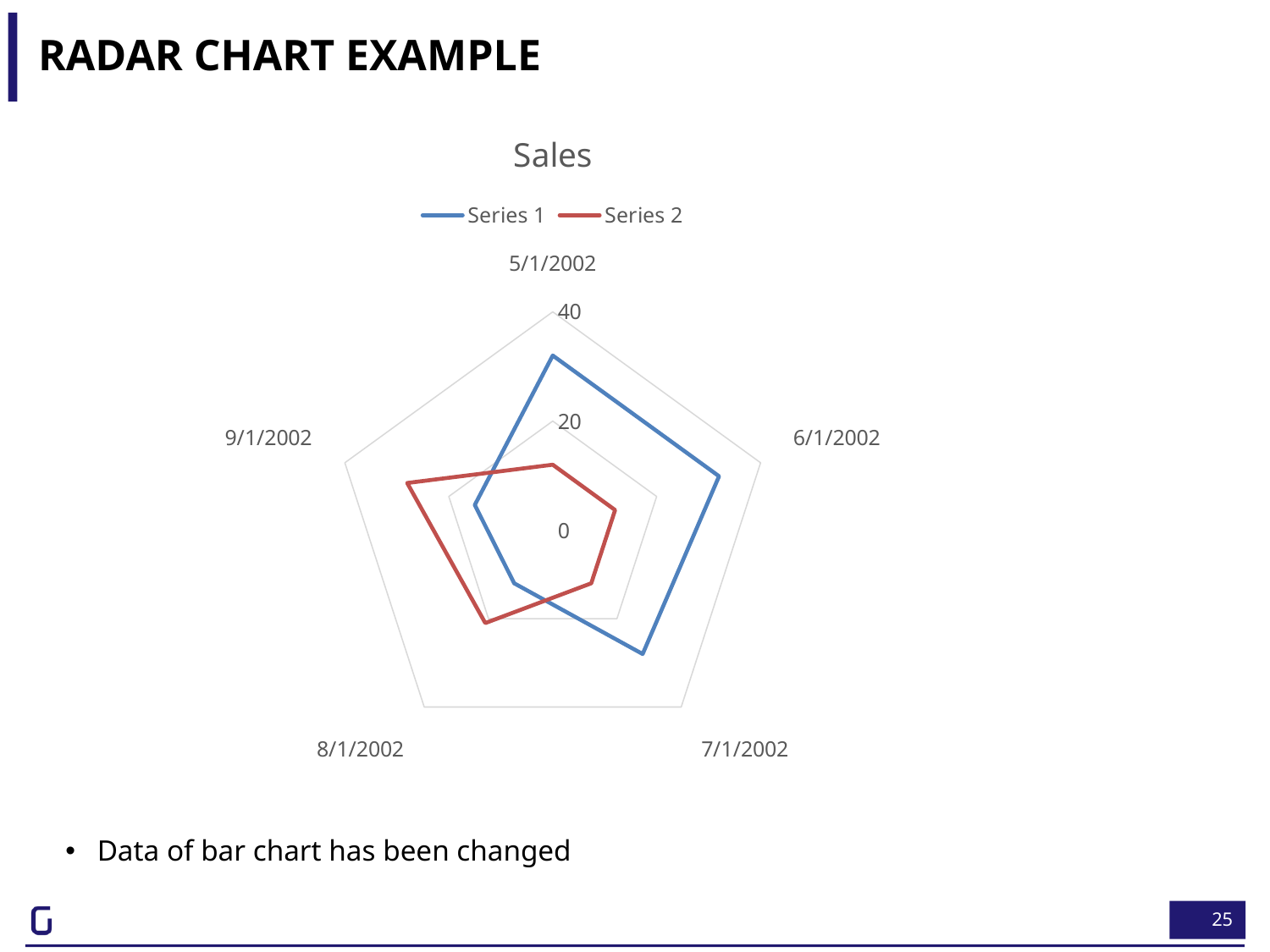
Is the Series 2 value for 9/1/2002 greater or less than 20? greater Is the Series 1 value for 5/1/2002 greater or less than 20? greater How many series does the legend list? 2 Which series has the larger value for 5/1/2002, Series 1 or Series 2? Series 1 What is the title of the chart? Sales Which series has the larger value for 9/1/2002, Series 1 or Series 2? Series 2 What kind of chart is shown on the slide? Radar chart Is the Series 2 value for 5/1/2002 greater or less than 20? less For Series 2, which date has the highest value? 9/1/2002 How many categories (dates) are plotted on the radar chart? 5